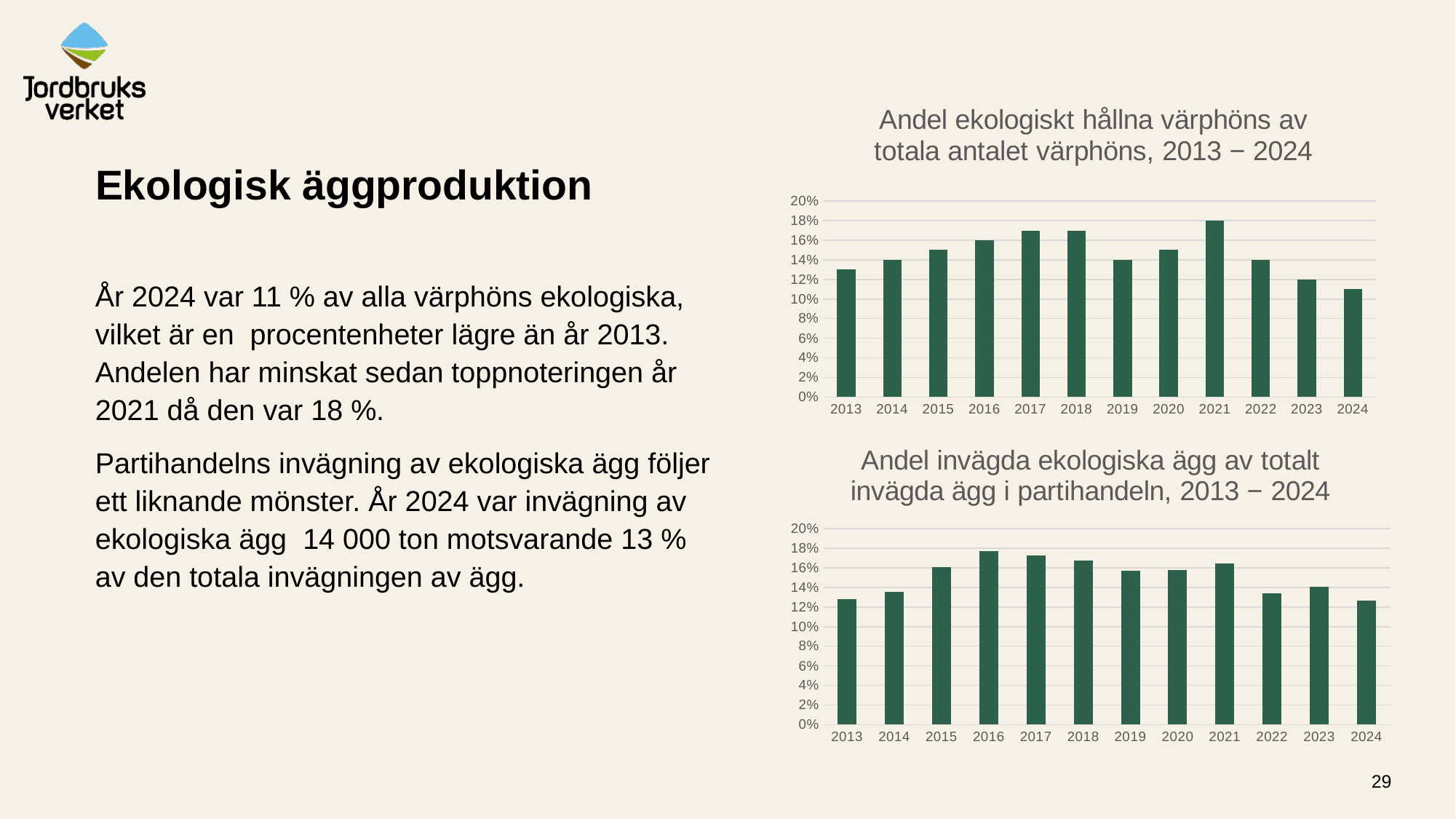
How many years are shown in the bottom chart 'Andel invägda ekologiska ägg av totalt invägda ägg i partihandeln'? 12 In the top chart 'Andel ekologiskt hållna värphöns av totala antalet värphöns', do the values rise or fall from 2021 to 2024? fall In the top chart 'Andel ekologiskt hållna värphöns av totala antalet värphöns', what is the value for 2024? 11% What kind of chart is the bottom chart 'Andel invägda ekologiska ägg av totalt invägda ägg i partihandeln'? bar chart In the top chart 'Andel ekologiskt hållna värphöns av totala antalet värphöns', what is the value for 2016? 16% In the bottom chart 'Andel invägda ekologiska ägg av totalt invägda ägg i partihandeln', is the value for 2024 greater or less than 14%? less In the top chart 'Andel ekologiskt hållna värphöns av totala antalet värphöns', which year has the lowest share? 2024 In the top chart 'Andel ekologiskt hållna värphöns av totala antalet värphöns', which year has the highest share? 2021 In the top chart 'Andel ekologiskt hållna värphöns av totala antalet värphöns', what is the value for 2021? 18% In the top chart 'Andel ekologiskt hållna värphöns av totala antalet värphöns', which is larger, the value for 2017 or the value for 2019? 2017 In the bottom chart 'Andel invägda ekologiska ägg av totalt invägda ägg i partihandeln', is the value for 2016 greater or less than 16%? greater In the bottom chart 'Andel invägda ekologiska ägg av totalt invägda ägg i partihandeln', which year has the highest share? 2016